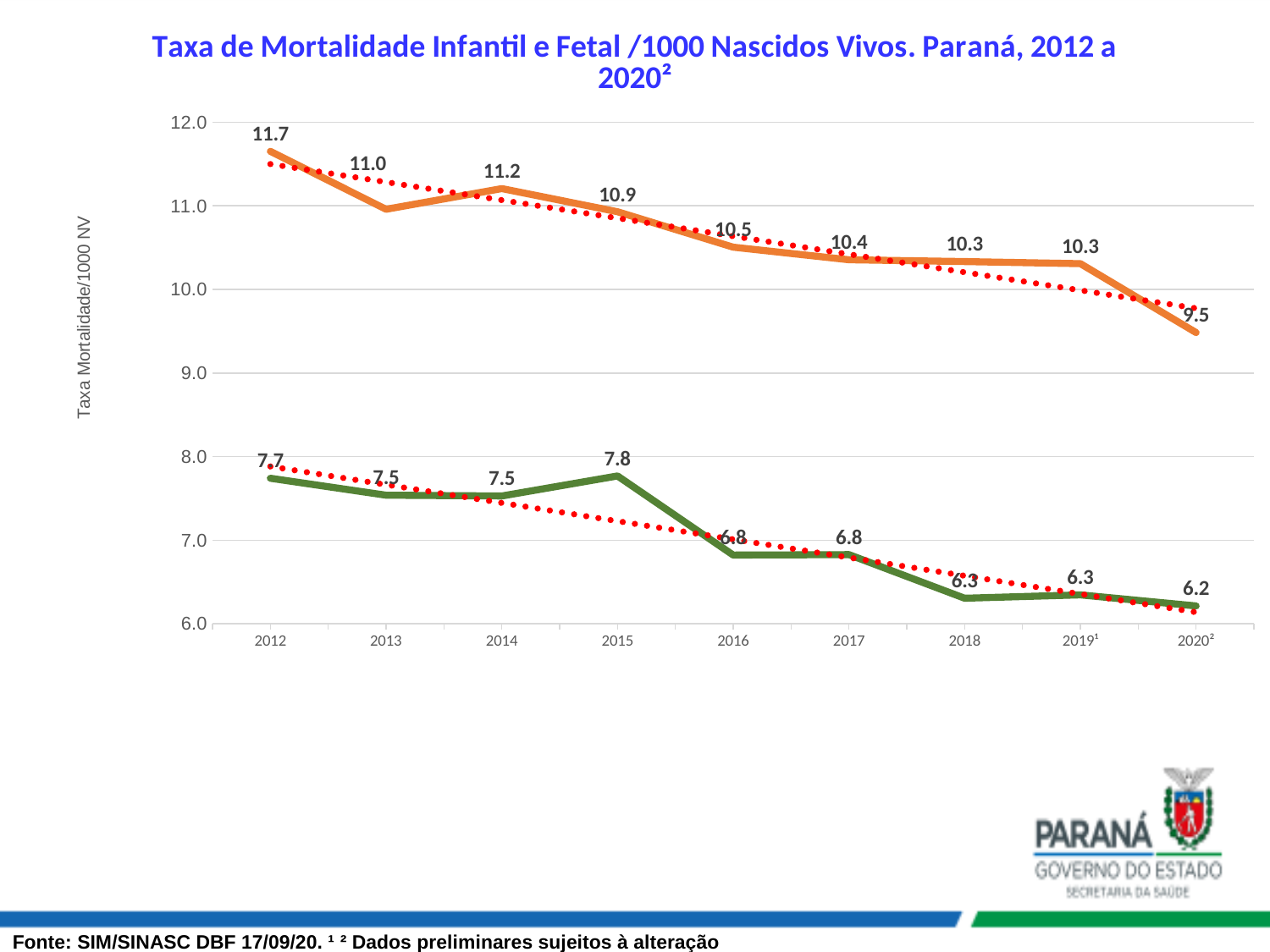
What is the value of the orange line in 2012? 11.7 In which year does the orange line reach its highest value? 2012 What is the value of the green line in 2018? 6.3 How many years are shown on the x axis? 9 What is the value of the green line in 2015? 7.8 What is the difference between the orange line's value in 2012 and its value in 2020²? 2.2 What is the value of the orange line in 2020²? 9.5 What is the label of the y axis? Taxa Mortalidade/1000 NV In which year does the green line reach its lowest value? 2020² Which is larger: the green line's value in 2015 or its value in 2016? 2015 Does the orange line generally rise or fall from 2012 to 2020²? fall What type of chart is shown on the slide? line chart